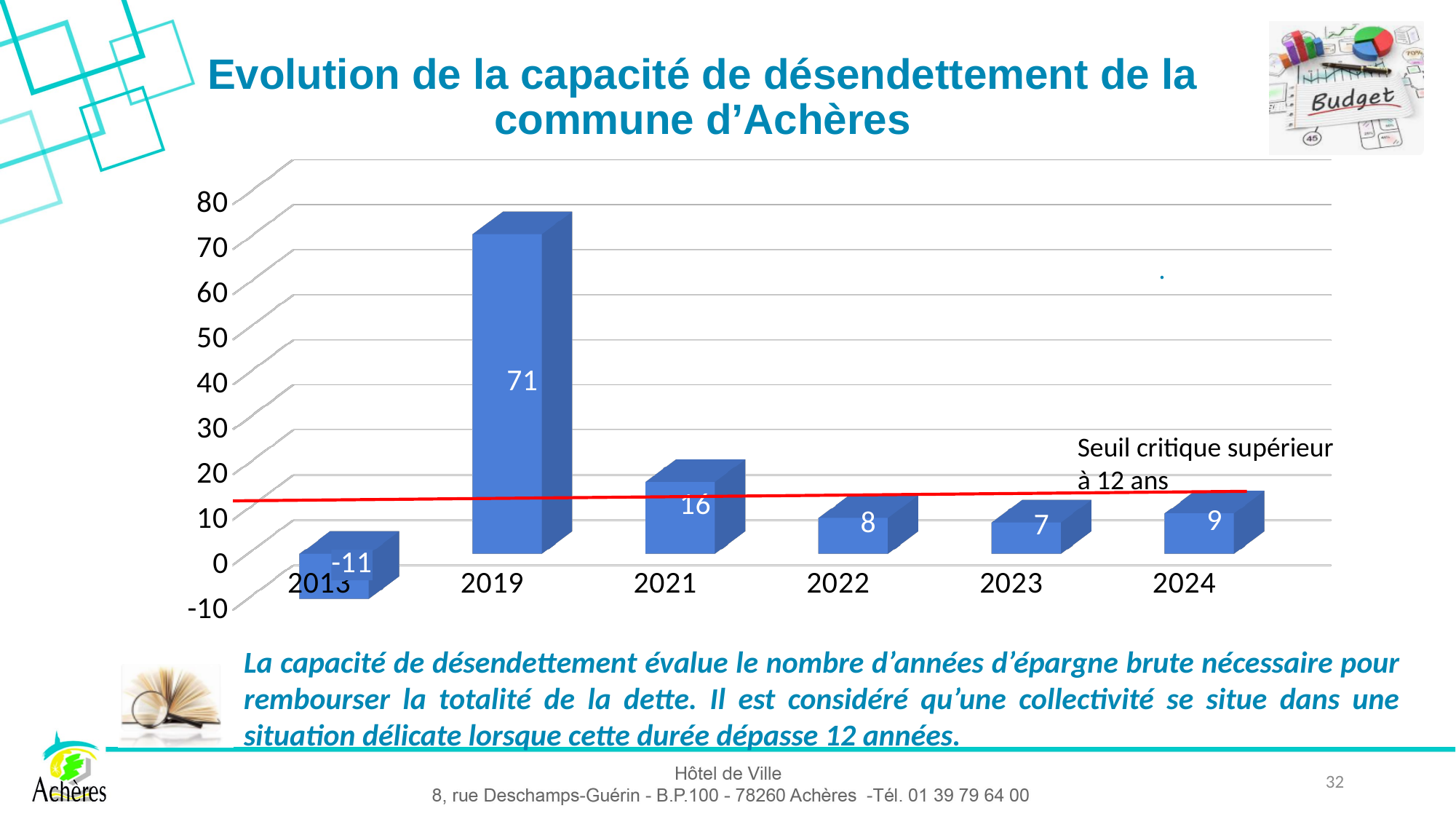
What is the value for 2021? 16 What is the value for 2019? 71 What does the label next to the red horizontal line say? Seuil critique supérieur à 12 ans Which is larger, the value for 2022 or the value for 2024? 2024 How many bars are plotted in the chart? 6 What is the value for 2022? 8 What is the value for 2023? 7 Do the values rise or fall from 2019 to 2023? fall Which year has the highest value? 2019 What kind of chart is shown on the slide? bar chart What is the difference between the values for 2019 and 2021? 55 What is the value for 2024? 9